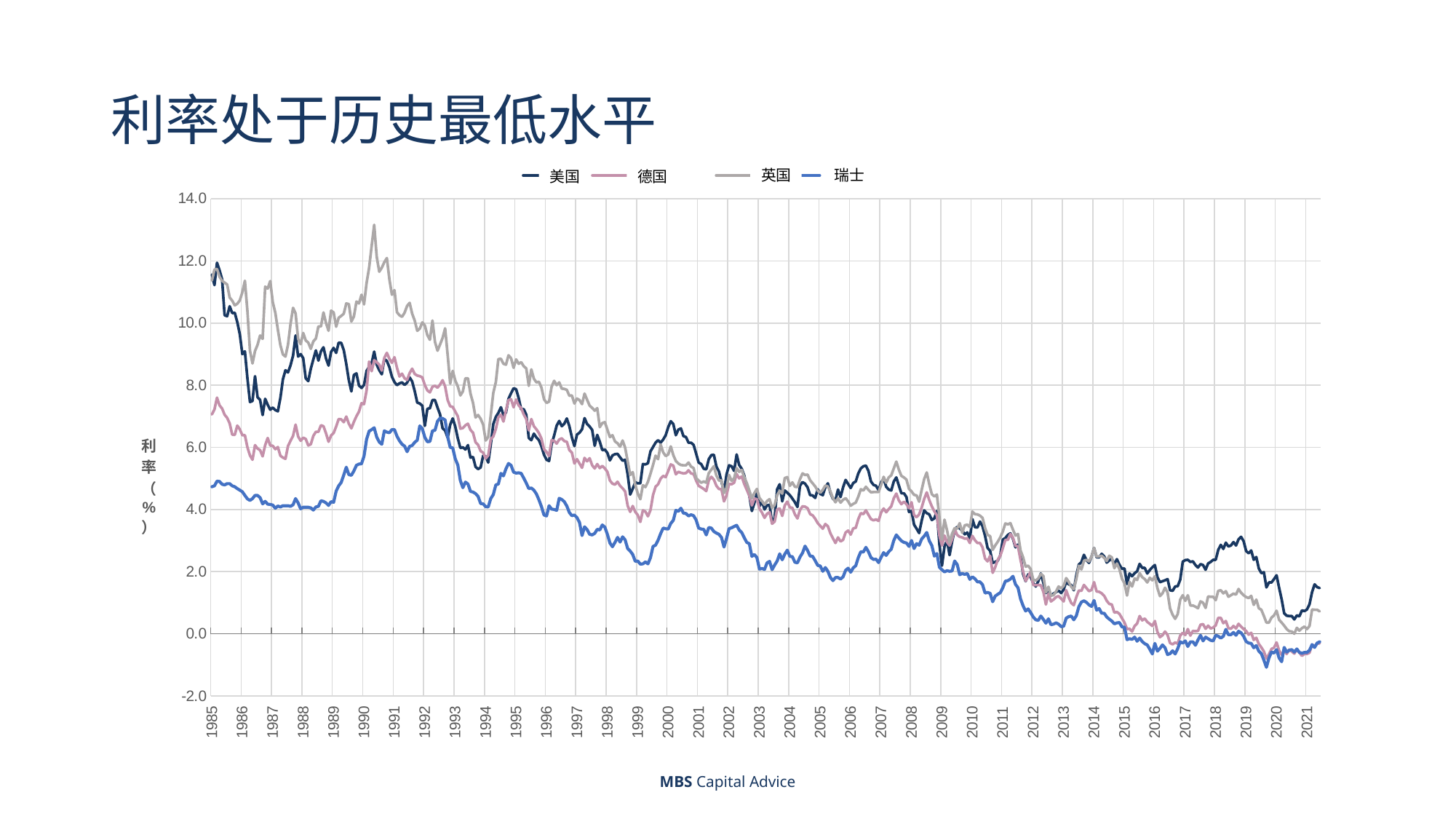
Overall, do the interest rates rise or fall from 1985 to 2021? fall Around 2019, which is larger, the value for 美国 or the value for 德国? 美国 What kind of chart is shown on the slide? line chart In 1985, which is larger, the value for 美国 or the value for 瑞士? 美国 Is the value for 英国 around 1990 greater or less than 12.0? greater Is the value for 美国 at the end of 2021 greater or less than 4.0? less Which series reaches the highest value anywhere on the chart? 英国 How many series does the legend list? 4 What is the title of the slide? 利率处于历史最低水平 Which series is the lowest in 1985? 瑞士 Which series is drawn in blue according to the legend? 瑞士 Is the value for 瑞士 in 1985 greater or less than 6.0? less